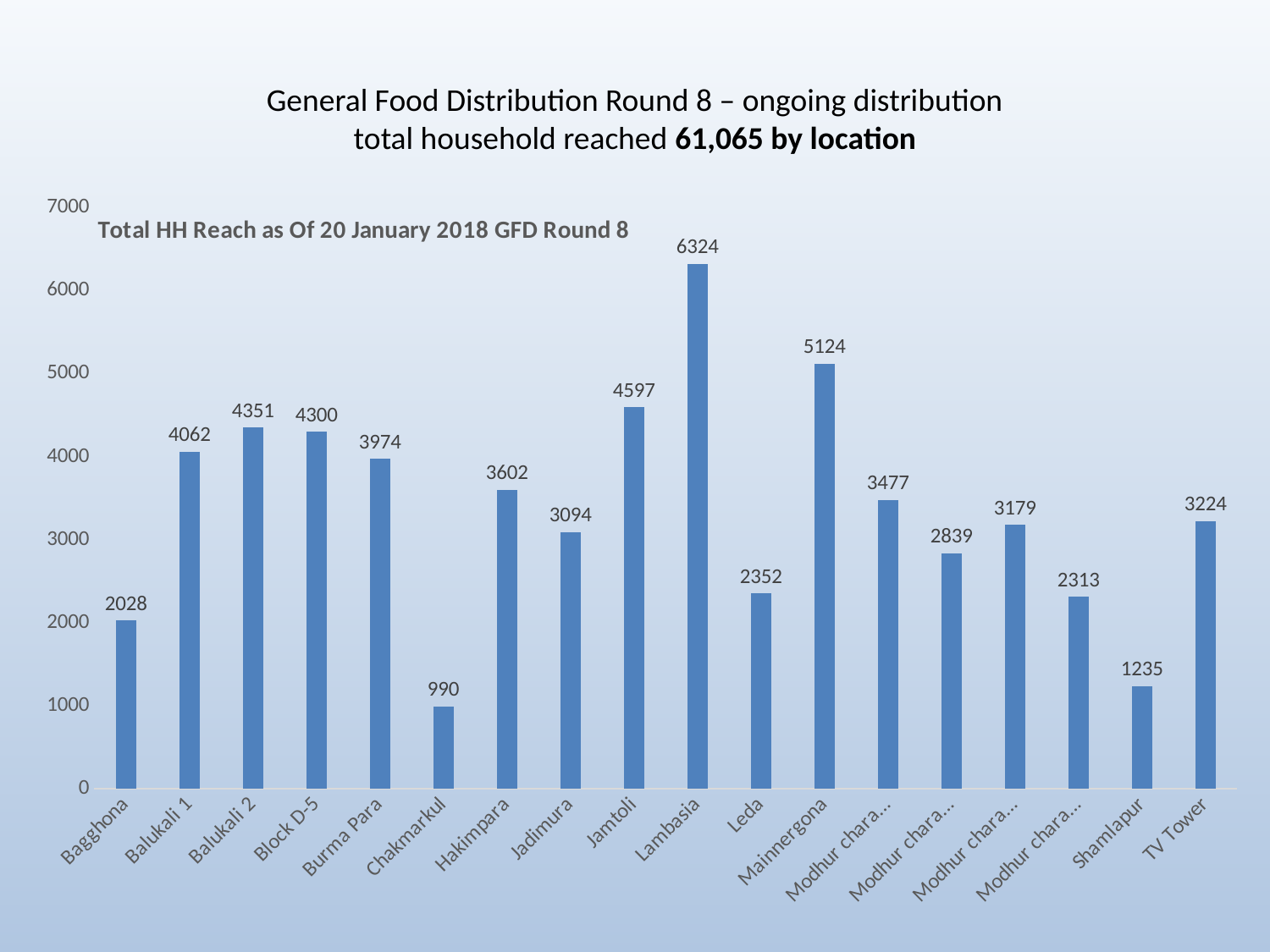
What is the difference between the values for Lambasia and Mainnergona? 1200 Which is larger, the value for Jamtoli or the value for Hakimpara? Jamtoli Is the value for Leda greater or less than 3000? less Which location has the highest value? Lambasia What kind of chart is shown on the slide? bar chart What is the difference between the values for Balukali 2 and Balukali 1? 289 Which location has the lowest value? Chakmarkul What is the value for Chakmarkul? 990 What is the value for Lambasia? 6324 What is the title printed inside the chart area? Total HH Reach as Of 20 January 2018 GFD Round 8 How many bars are shown in the chart? 18 What is the value for TV Tower? 3224